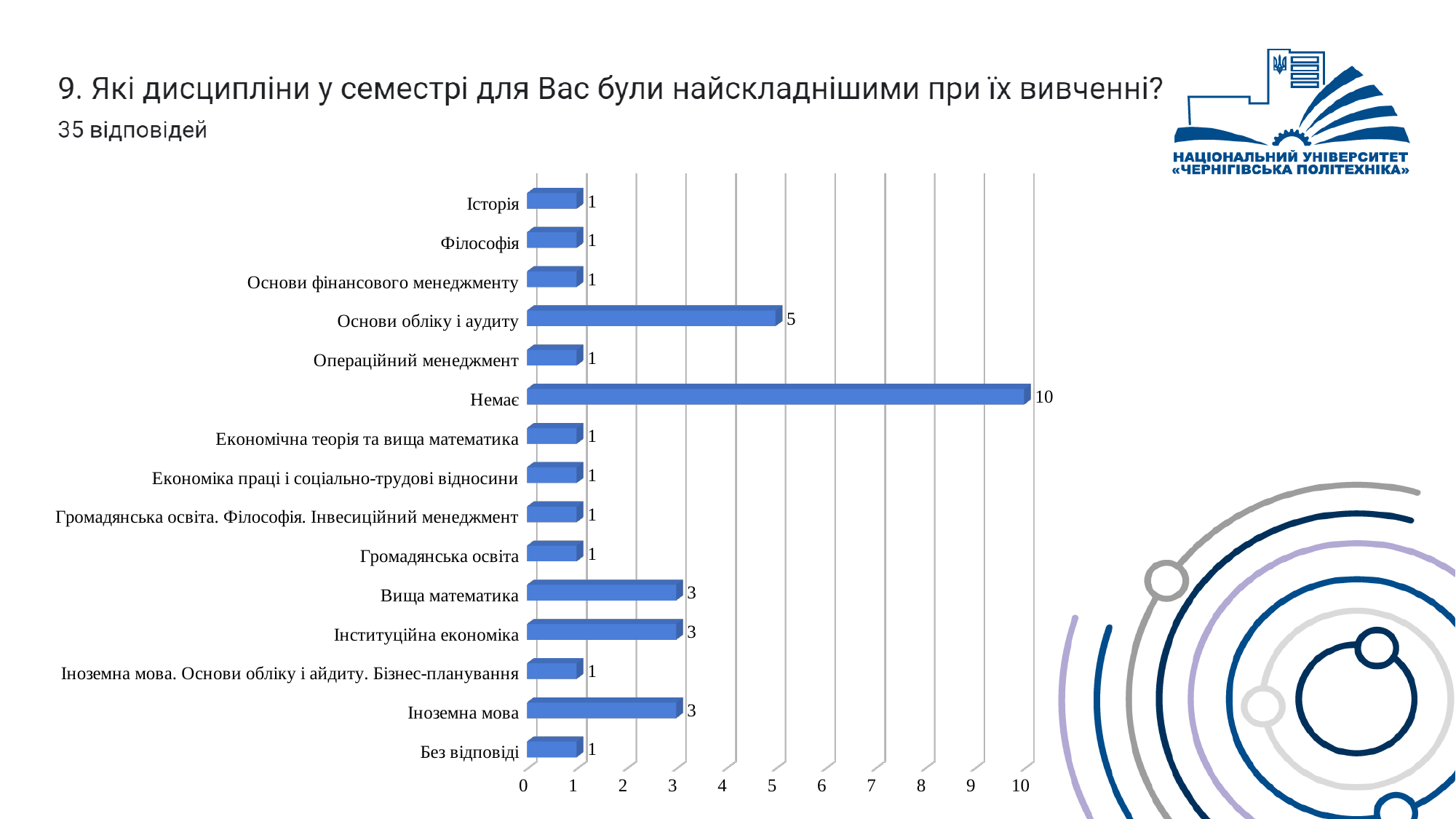
What is the value for Вища математика? 3 How many responses does the slide say the chart is based on? 35 відповідей What is the value for Іноземна мова? 3 What type of chart is shown on the slide? bar chart What is the value for Історія? 1 What is the difference between the values for Основи обліку і аудиту and Вища математика? 2 What is the value for Основи обліку і аудиту? 5 How many categories are plotted in the chart? 15 What is the value for Немає? 10 What is the difference between the values for Немає and Основи обліку і аудиту? 5 Which category has the highest value in the chart? Немає Which is larger, the value for Інституційна економіка or the value for Філософія? Інституційна економіка